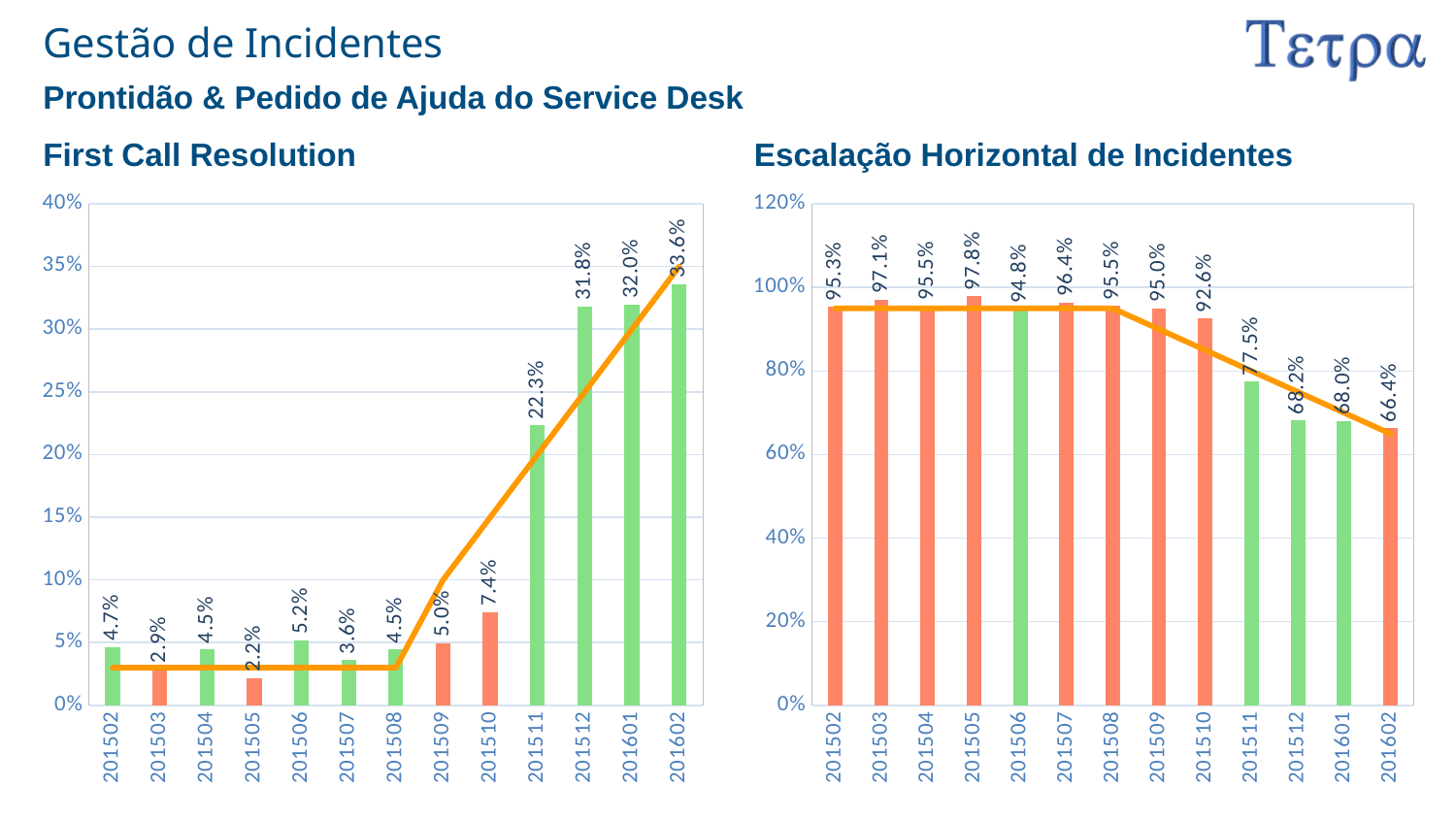
In the First Call Resolution chart, what is the difference between the values for 201602 and 201512? 1.8% In the First Call Resolution chart, what is the value for 201505? 2.2% In the First Call Resolution chart, how many periods are shown on the x axis? 13 In the First Call Resolution chart, which period has the highest value? 201602 In the Escalação Horizontal de Incidentes chart, which period has the lowest value? 201602 In the Escalação Horizontal de Incidentes chart, what is the value for 201505? 97.8% In the First Call Resolution chart, which period has the lowest value? 201505 In the First Call Resolution chart, what is the value for 201511? 22.3% In the Escalação Horizontal de Incidentes chart, what is the difference between the values for 201511 and 201512? 9.3% In the Escalação Horizontal de Incidentes chart, what is the value for 201602? 66.4% What kind of chart is the Escalação Horizontal de Incidentes chart? Bar chart with a line In the Escalação Horizontal de Incidentes chart, which is larger, the value for 201510 or the value for 201511? 201510